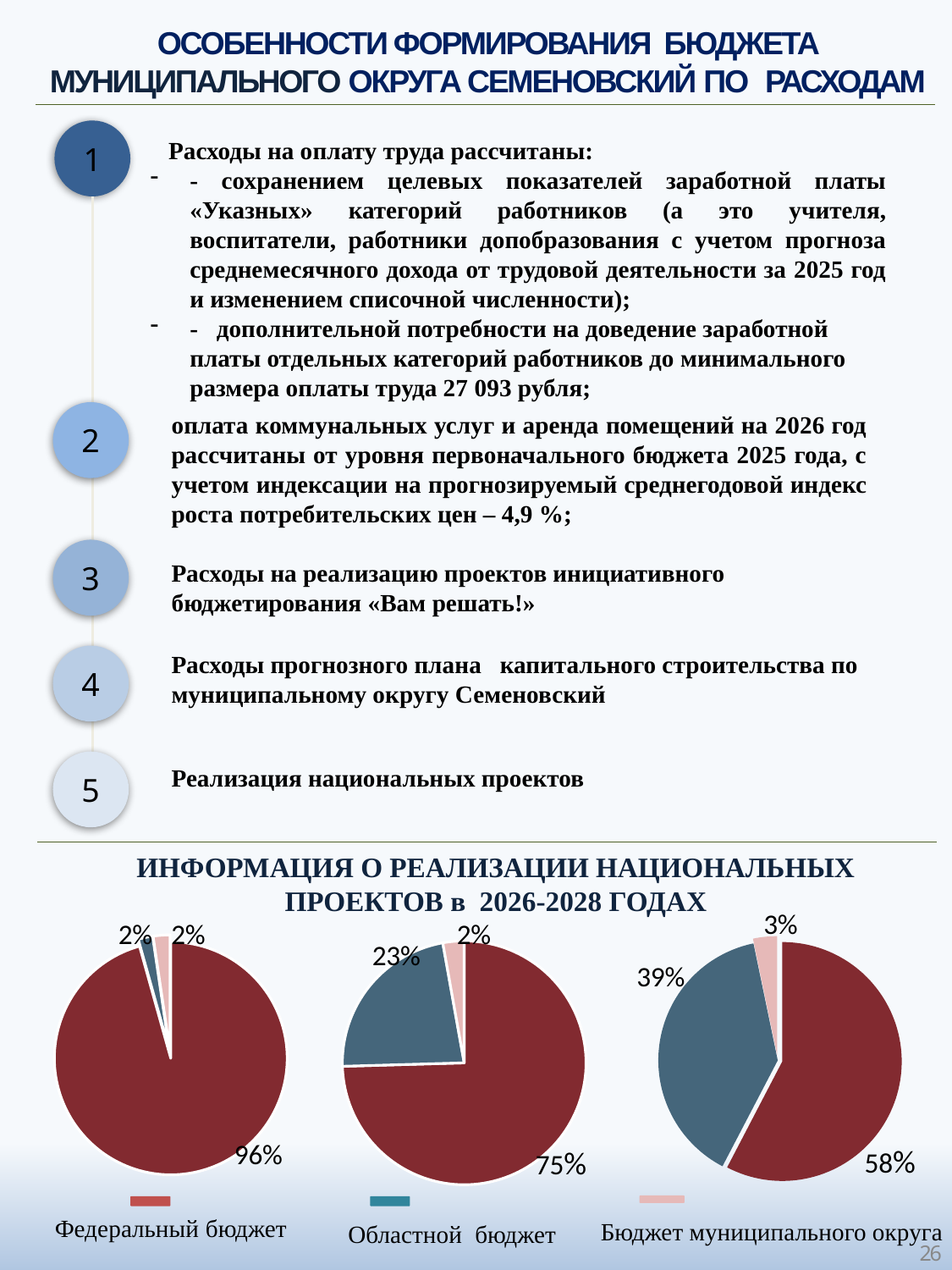
In the middle pie chart, what is the difference between the Федеральный бюджет share and the Областной бюджет share? 52% Which is larger: the Областной бюджет share in the middle pie chart or in the right pie chart? Right pie chart In the right pie chart, which category has the largest share? Федеральный бюджет In the right pie chart, what is the difference between the Федеральный бюджет share and the Областной бюджет share? 19% What type of charts are shown at the bottom of the slide? Pie charts In the left pie chart, what share does the Федеральный бюджет slice have? 96% In the right pie chart, what is the value for Бюджет муниципального округа? 3% How many pie charts are shown on the slide? 3 How many categories does the legend below the pie charts list? 3 In the middle pie chart, which category has the smallest share? Бюджет муниципального округа In the middle pie chart, what is the value for Областной бюджет? 23% What is the title above the pie charts? ИНФОРМАЦИЯ О РЕАЛИЗАЦИИ НАЦИОНАЛЬНЫХ ПРОЕКТОВ в 2026-2028 ГОДАХ